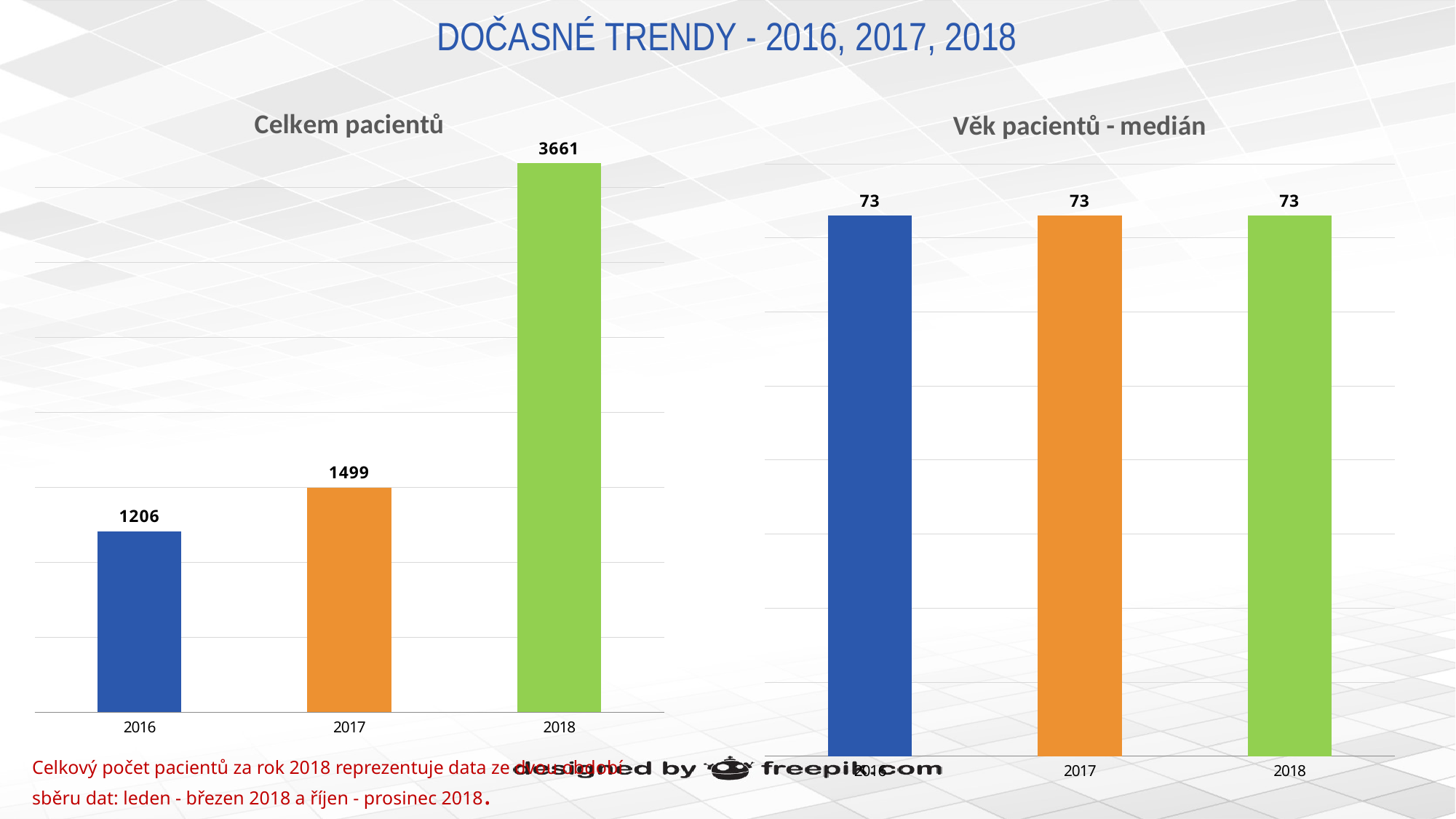
In the 'Celkem pacientů' chart, what is the value for 2017? 1499 In the 'Celkem pacientů' chart, what is the difference between the values for 2018 and 2017? 2162 In the 'Věk pacientů - medián' chart, what is the value for 2017? 73 In the 'Celkem pacientů' chart, what is the value for 2018? 3661 What kind of chart is the 'Celkem pacientů' chart? bar chart How many bars are in the 'Věk pacientů - medián' chart? 3 What is the title of the chart on the right side of the slide? Věk pacientů - medián In the 'Celkem pacientů' chart, what is the value for 2016? 1206 In the 'Celkem pacientů' chart, which year has the lowest value? 2016 In the 'Celkem pacientů' chart, do the values rise or fall from 2016 to 2018? rise In the 'Celkem pacientů' chart, which year has the highest value? 2018 In the 'Celkem pacientů' chart, what is the difference between the values for 2017 and 2016? 293